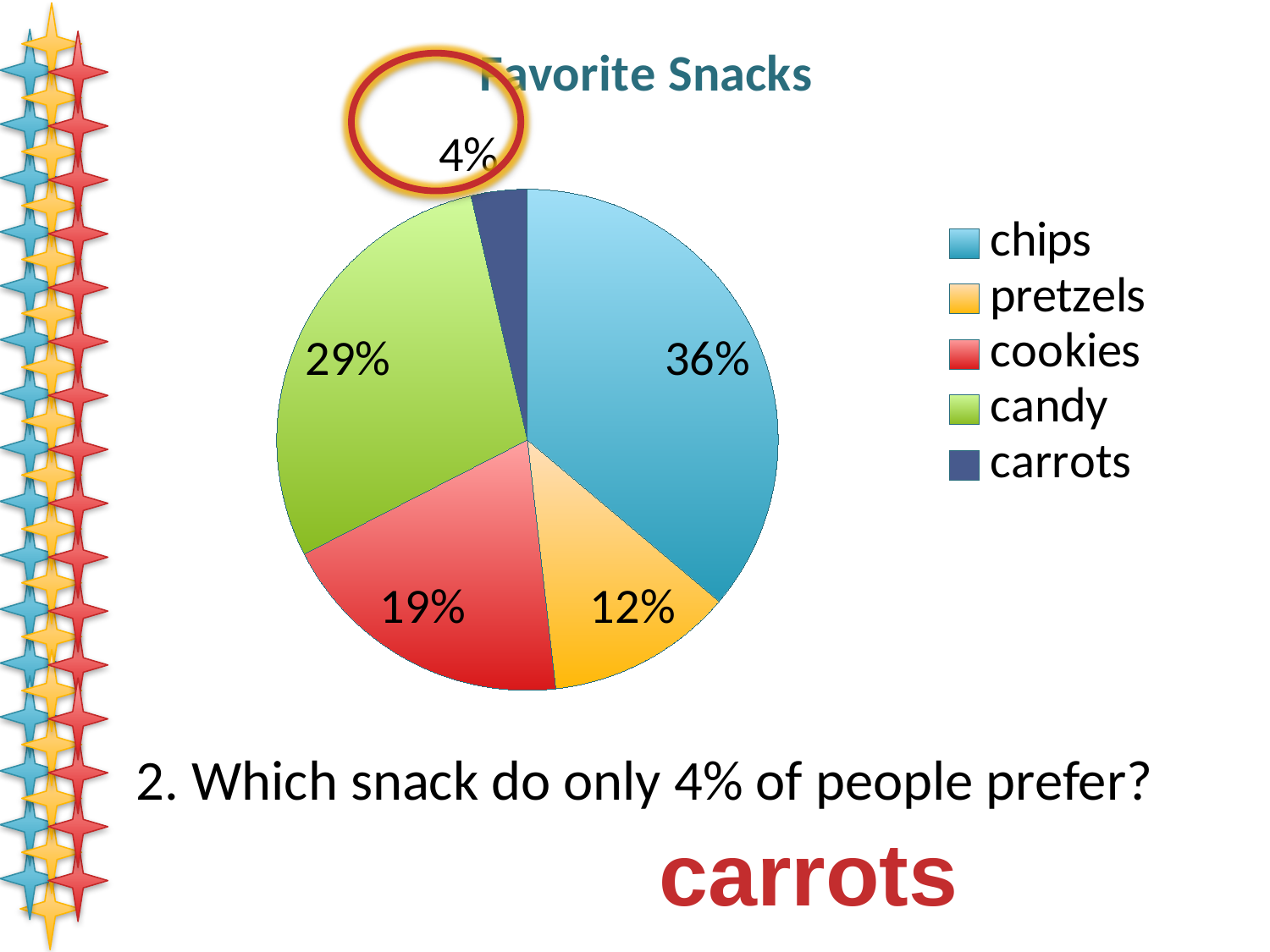
What kind of chart is shown on the slide? pie chart Which snack has the smallest share of the pie? carrots Which snack has the largest share of the pie? chips How many snack categories are shown in the pie chart? 5 What percentage of people prefer candy? 29% What is the difference in percentage points between chips and candy? 7 What percentage of people prefer pretzels? 12% What is the title of the chart? Favorite Snacks What is the difference in percentage points between cookies and pretzels? 7 Which has a larger share, cookies or pretzels? cookies What percentage of people prefer chips? 36% What percentage of people prefer cookies? 19%